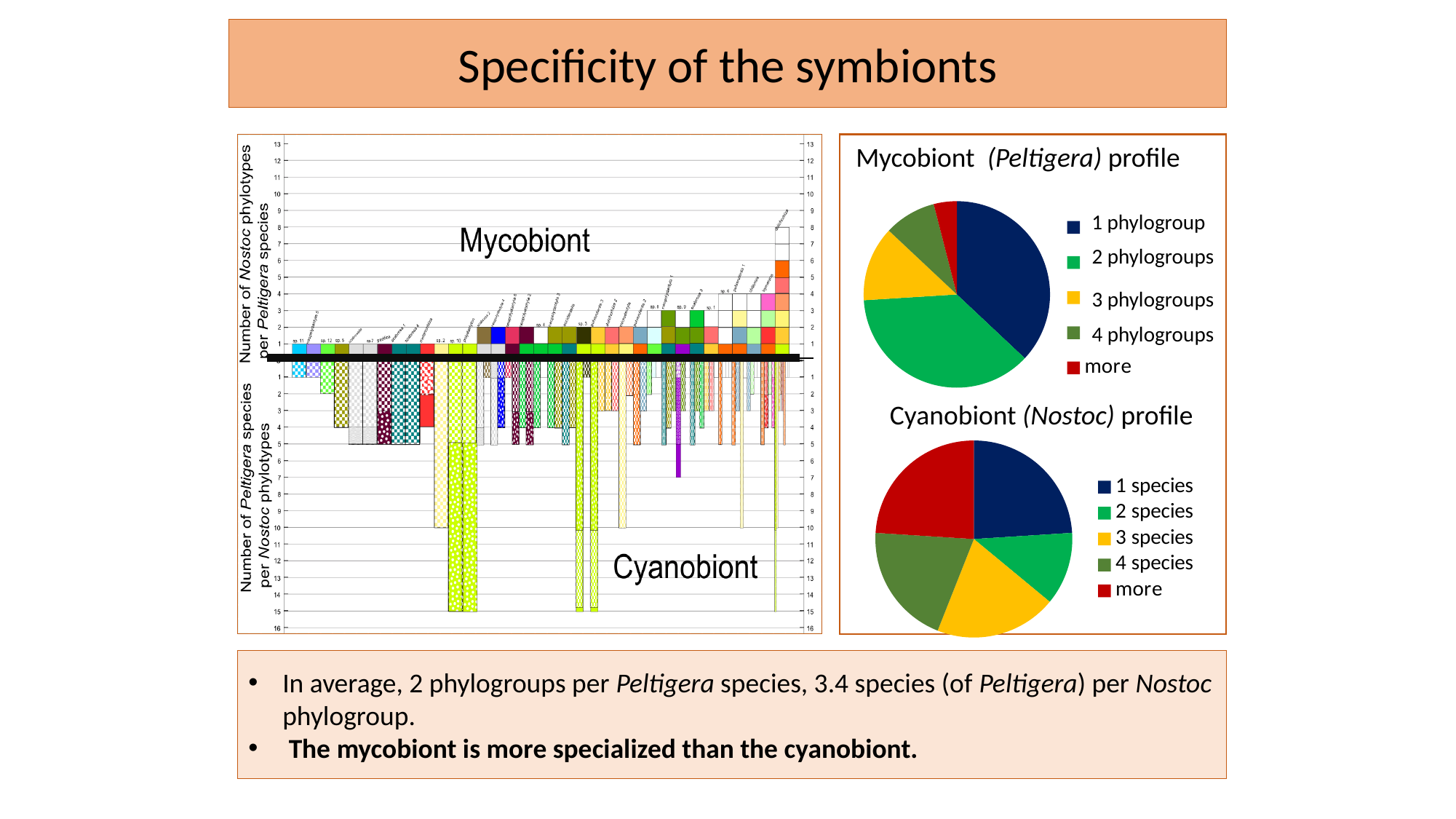
In the 'Mycobiont (Peltigera) profile' pie chart, which slice is larger: '3 phylogroups' or '4 phylogroups'? 3 phylogroups How many entries does the legend of the 'Mycobiont (Peltigera) profile' pie chart list? 5 In the 'Cyanobiont (Nostoc) profile' pie chart, which slice is larger: '3 species' or '2 species'? 3 species What type of chart is the 'Mycobiont (Peltigera) profile' chart? pie chart What type of chart is the 'Cyanobiont (Nostoc) profile' chart? pie chart In the large chart on the left, what is the highest tick value shown on the upper (Mycobiont) vertical axis? 13 How many entries does the legend of the 'Cyanobiont (Nostoc) profile' pie chart list? 5 In the 'Cyanobiont (Nostoc) profile' pie chart, which slice is larger: '4 species' or '2 species'? 4 species What colour represents the 'more' category in both pie charts? red What type of chart is the large chart on the left of the slide labelled 'Mycobiont' and 'Cyanobiont'? bar chart In the 'Mycobiont (Peltigera) profile' pie chart, which category has the smallest slice? more In the 'Cyanobiont (Nostoc) profile' pie chart, which category has the smallest slice? 2 species